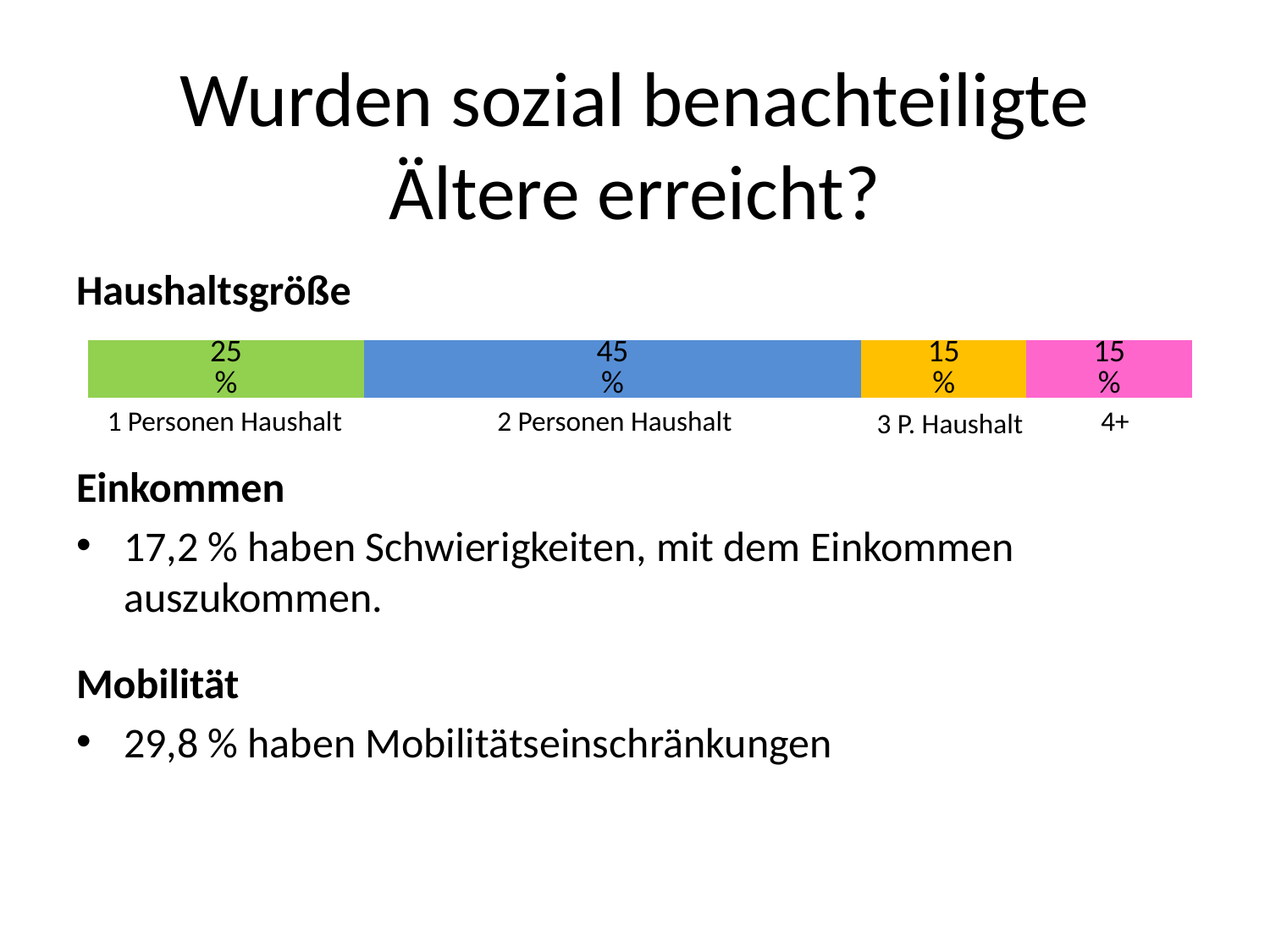
What colour is the 2 Personen Haushalt segment in the Haushaltsgröße bar? Blue In the Haushaltsgröße bar, what is the value for the 4+ category? 15% What kind of chart is used to show Haushaltsgröße? Stacked bar chart How many household size categories are shown in the Haushaltsgröße bar? 4 In the Haushaltsgröße bar, what is the value for 1 Personen Haushalt? 25% In the Haushaltsgröße bar, what is the value for 2 Personen Haushalt? 45% In the Haushaltsgröße bar, which is larger: 1 Personen Haushalt or 3 P. Haushalt? 1 Personen Haushalt In the Haushaltsgröße bar, what is the difference between the 2 Personen Haushalt and 1 Personen Haushalt values? 20 percentage points In the Haushaltsgröße bar, which is larger: 1 Personen Haushalt or 2 Personen Haushalt? 2 Personen Haushalt What is the total of all segments in the Haushaltsgröße bar? 100% Which household size category has the highest share in the Haushaltsgröße bar? 2 Personen Haushalt In the Haushaltsgröße bar, what is the value for 3 P. Haushalt? 15%